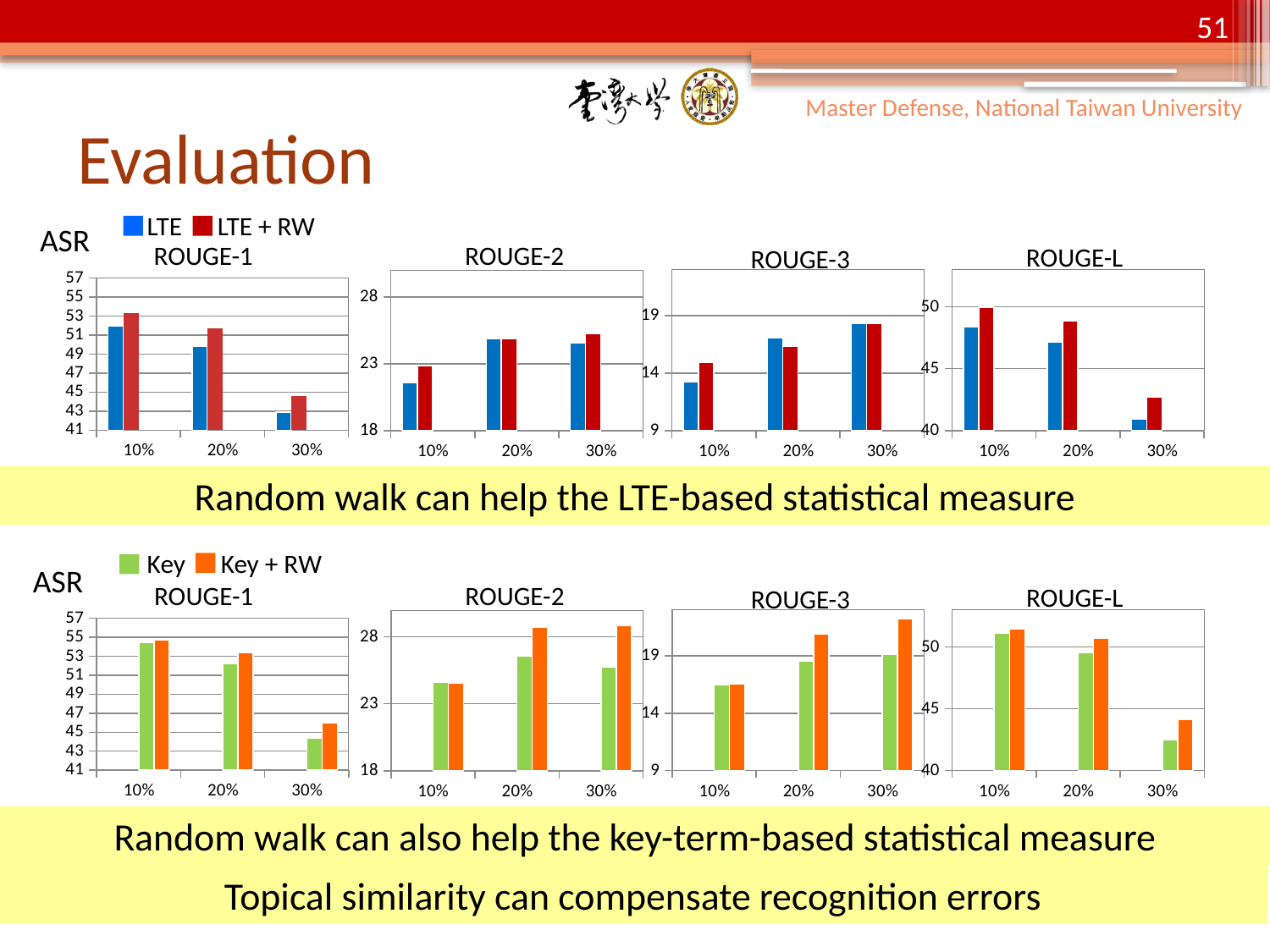
How many categories are shown on the x axis of the top ROUGE-1 chart? 3 In the top ROUGE-1 chart (LTE vs LTE + RW), is the LTE value at 30% greater or less than 45? less What are the two legend entries for the bottom row of charts? Key and Key + RW In the top ROUGE-1 chart, which series has the larger value at 10%, LTE or LTE + RW? LTE + RW In the bottom ROUGE-3 chart, which series has the larger value at 30%, Key or Key + RW? Key + RW In the top ROUGE-1 chart, at which x-axis category is the LTE + RW series highest? 10% In the top ROUGE-3 chart (LTE vs LTE + RW), is the LTE value at 10% greater or less than 14? less In the top ROUGE-L chart (LTE vs LTE + RW), is the LTE + RW value at 10% greater or less than 45? greater What kind of chart is the top ROUGE-1 chart (LTE vs LTE + RW)? bar chart In the bottom ROUGE-1 chart (Key vs Key + RW), do the Key values rise or fall from 10% to 30%? fall How many series does the legend of the top row of charts list? 2